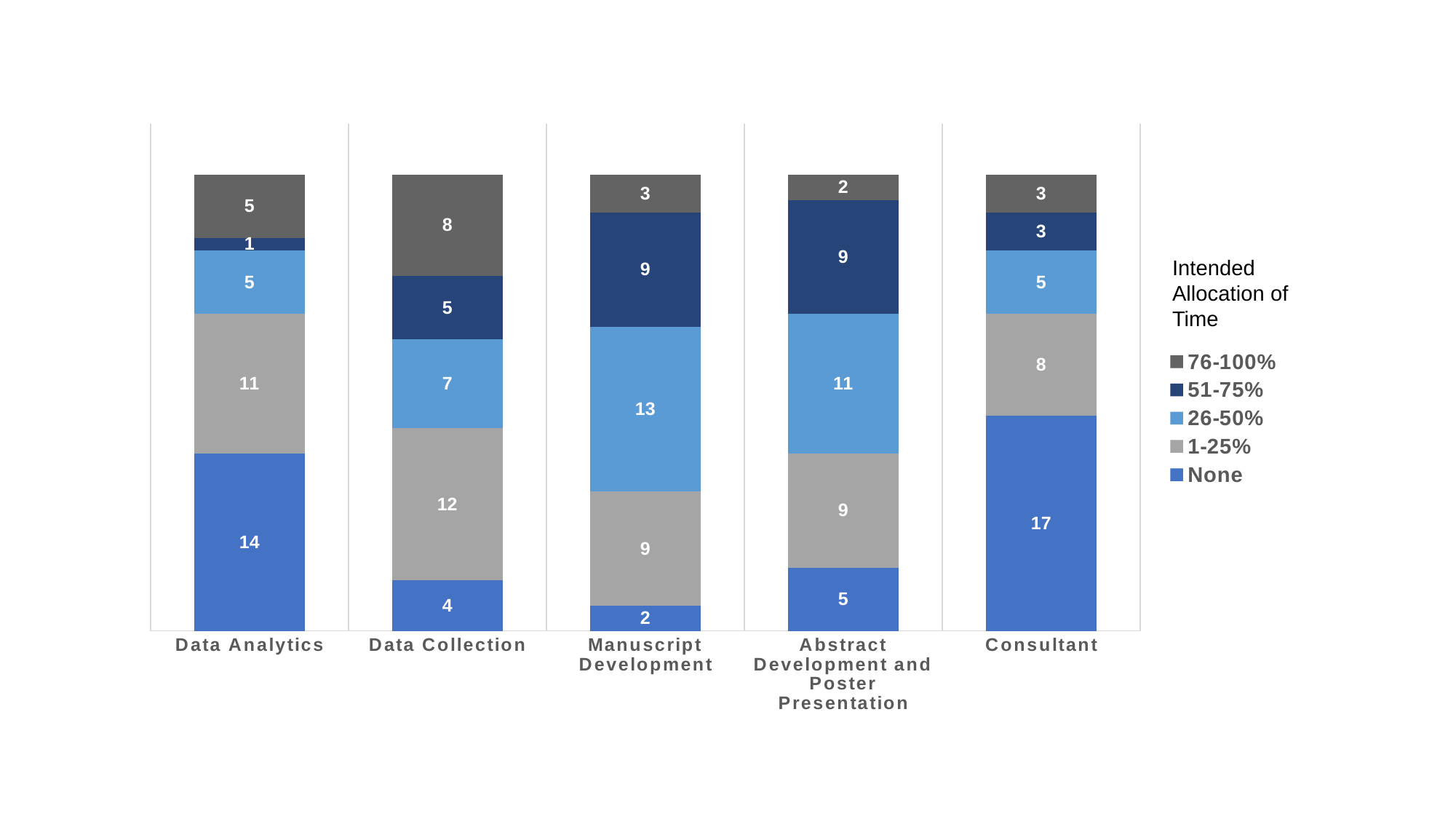
What is the value for "None" in the Data Analytics bar? 14 What kind of chart is shown on the slide? Stacked bar chart Which category has the lowest value for "51-75%"? Data Analytics Which is larger: the "76-100%" value for Data Analytics or for Consultant? Data Analytics What is the value for "51-75%" in the Abstract Development and Poster Presentation bar? 9 What is the value for "26-50%" in the Manuscript Development bar? 13 What is the total of the stacked bar for Consultant? 36 How many categories are shown on the x axis? 5 Which category has the highest value for "None"? Consultant What is the difference between the "1-25%" values for Data Collection and Consultant? 4 How many series does the legend list? 5 What is the value for "76-100%" in the Data Collection bar? 8